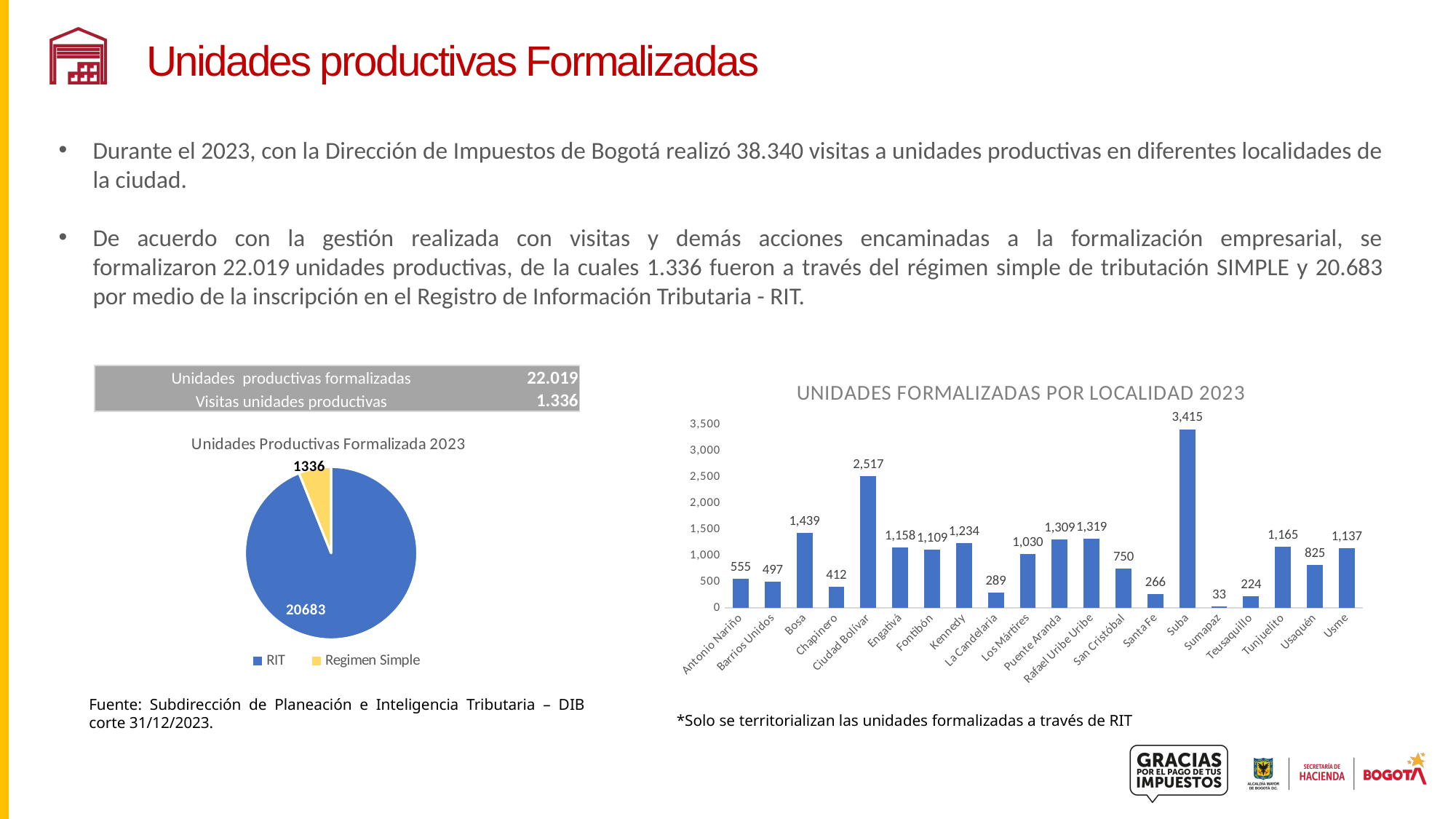
In the bar chart 'UNIDADES FORMALIZADAS POR LOCALIDAD 2023', which locality has the highest value? Suba In the bar chart 'UNIDADES FORMALIZADAS POR LOCALIDAD 2023', what is the difference between the values for Suba and Ciudad Bolívar? 898 In the bar chart 'UNIDADES FORMALIZADAS POR LOCALIDAD 2023', what is the value for Teusaquillo? 224 In the bar chart 'UNIDADES FORMALIZADAS POR LOCALIDAD 2023', how many localities are shown? 20 In the pie chart 'Unidades Productivas Formalizada 2023', what is the value for RIT? 20683 In the bar chart 'UNIDADES FORMALIZADAS POR LOCALIDAD 2023', which is larger, the value for Bosa or the value for Kennedy? Bosa In the bar chart 'UNIDADES FORMALIZADAS POR LOCALIDAD 2023', what is the value for Suba? 3,415 In the pie chart 'Unidades Productivas Formalizada 2023', what is the value for Regimen Simple? 1336 What type of chart is 'UNIDADES FORMALIZADAS POR LOCALIDAD 2023'? Bar chart In the bar chart 'UNIDADES FORMALIZADAS POR LOCALIDAD 2023', which locality has the lowest value? Sumapaz In the bar chart 'UNIDADES FORMALIZADAS POR LOCALIDAD 2023', what is the value for Ciudad Bolívar? 2,517 How many series does the legend of the pie chart 'Unidades Productivas Formalizada 2023' list? 2